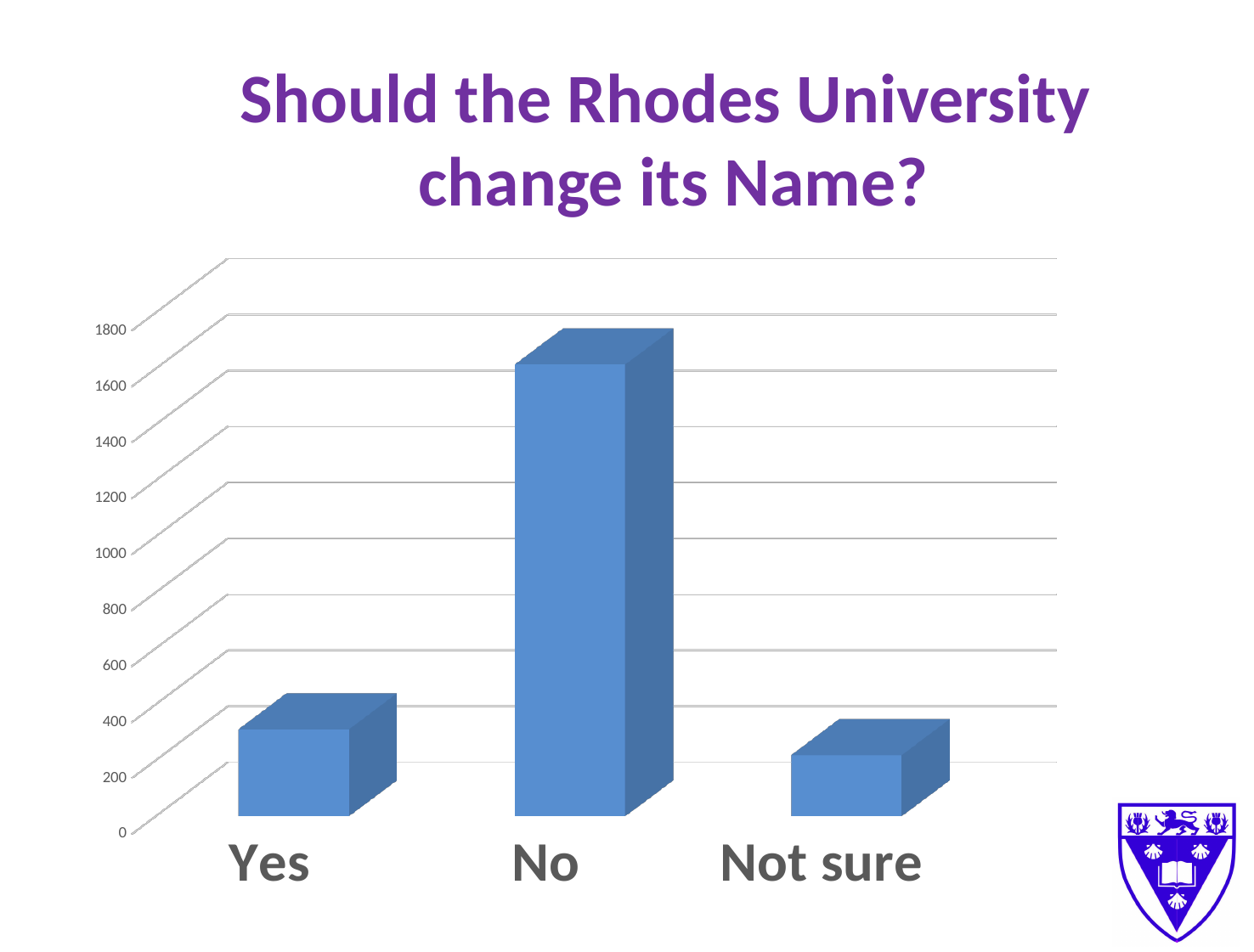
Is the value for No greater or less than 1800? less What is the highest value labelled on the vertical axis? 1800 Is the value for Not sure greater or less than 400? less What is the title of the chart? Should the Rhodes University change its Name? How many categories are shown on the x axis? 3 Is the value for Yes greater or less than 600? less Which category has the highest value? No Which is larger, the value for Yes or the value for Not sure? Yes What kind of chart is shown on the slide? bar chart Which category has the lowest value? Not sure Which is larger, the value for No or the value for Yes? No